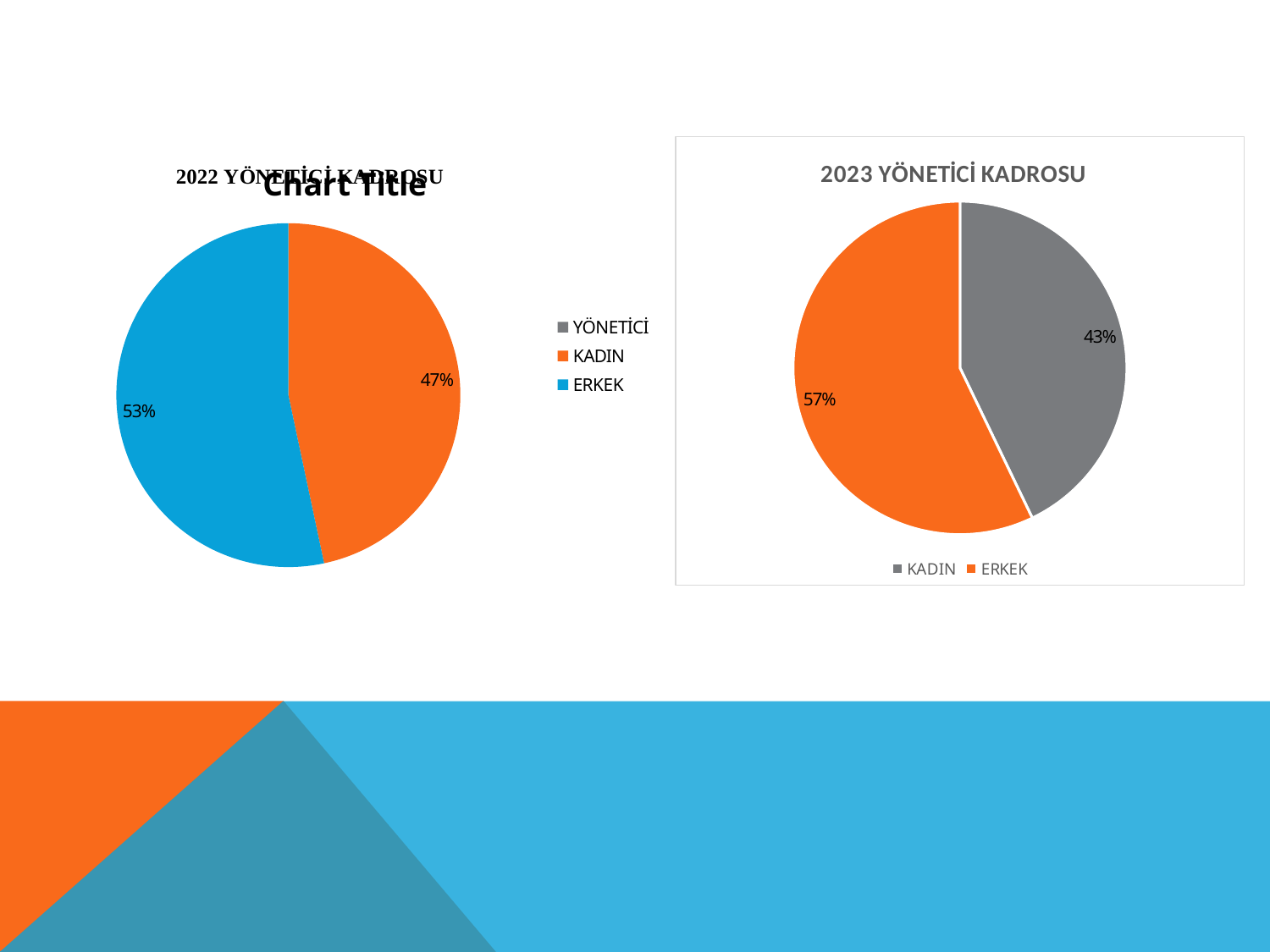
In the left pie chart (2022), what percentage is shown for the KADIN slice? 47% In the 2023 YÖNETİCİ KADROSU chart, which slice is the largest? ERKEK In the 2023 YÖNETİCİ KADROSU chart, what percentage is shown for ERKEK? 57% What type of chart is the 2023 YÖNETİCİ KADROSU chart? pie chart In the left pie chart (2022), which slice is the smallest? KADIN How many entries does the legend of the 2023 YÖNETİCİ KADROSU chart list? 2 In the 2023 YÖNETİCİ KADROSU chart, what percentage is shown for KADIN? 43% In the left pie chart (2022), what is the difference between the ERKEK and KADIN percentages? 6% Is the KADIN share larger in the left (2022) chart or in the 2023 YÖNETİCİ KADROSU chart? the left (2022) chart In the 2023 YÖNETİCİ KADROSU chart, what is the difference between the ERKEK and KADIN percentages? 14% In the 2023 YÖNETİCİ KADROSU chart, what colour is the ERKEK slice? orange In the left pie chart (2022), what percentage is shown for the ERKEK slice? 53%